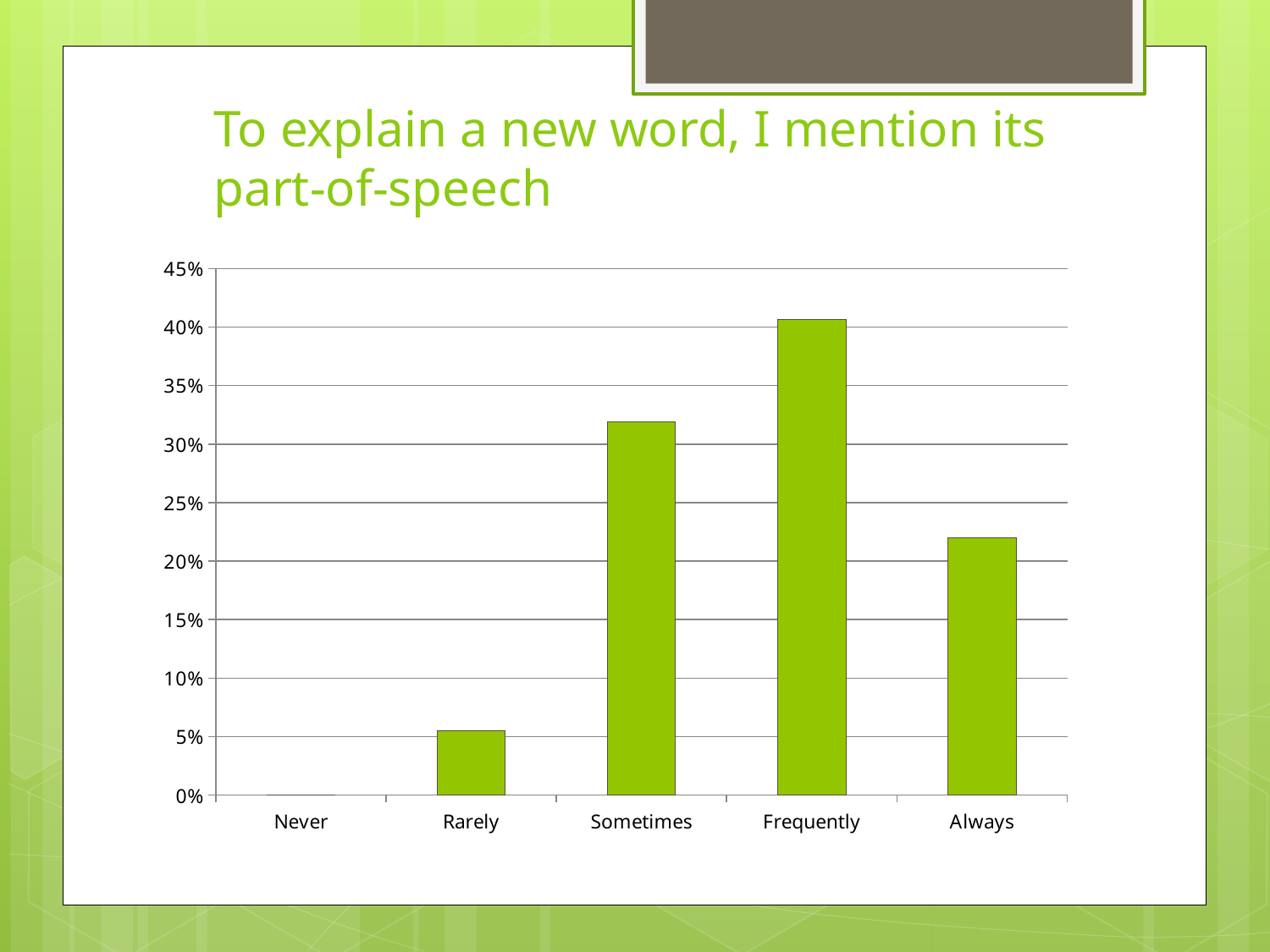
Is the value for Frequently greater or less than 35%? greater Which is larger, the value for Sometimes or the value for Always? Sometimes Is the value for Sometimes greater or less than 30%? greater How many categories are shown on the x axis of the chart? 5 What is the title of the chart on the slide? To explain a new word, I mention its part-of-speech Is the value for Rarely greater or less than 10%? less What is the highest value shown on the y axis of the chart? 45% What kind of chart is shown on the slide? bar chart Which category has the lowest value in the chart? Never Which category has the highest value in the chart? Frequently Which is larger, the value for Rarely or the value for Always? Always